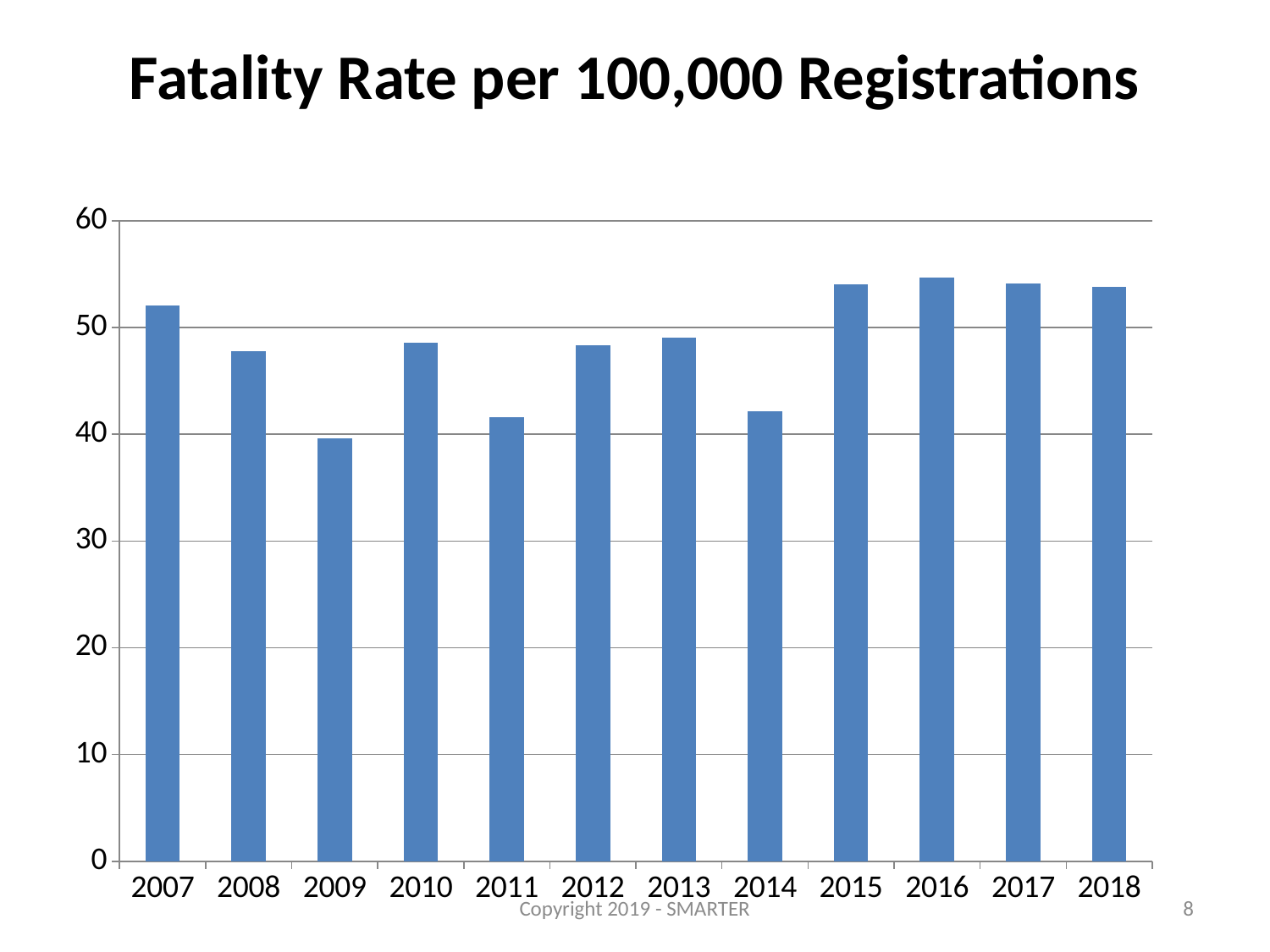
Is the value for 2014 greater or less than 40? greater Is the value for 2007 greater or less than 50? greater How many years are shown on the x axis of the chart? 12 Which year has the lowest fatality rate per 100,000 registrations? 2009 Which year has the larger value, 2007 or 2008? 2007 Does the fatality rate rise or fall from 2014 to 2015? rise Which year has the larger value, 2009 or 2014? 2014 Is the value for 2008 greater or less than 50? less What is the title of the chart? Fatality Rate per 100,000 Registrations What kind of chart is shown on the slide? bar chart